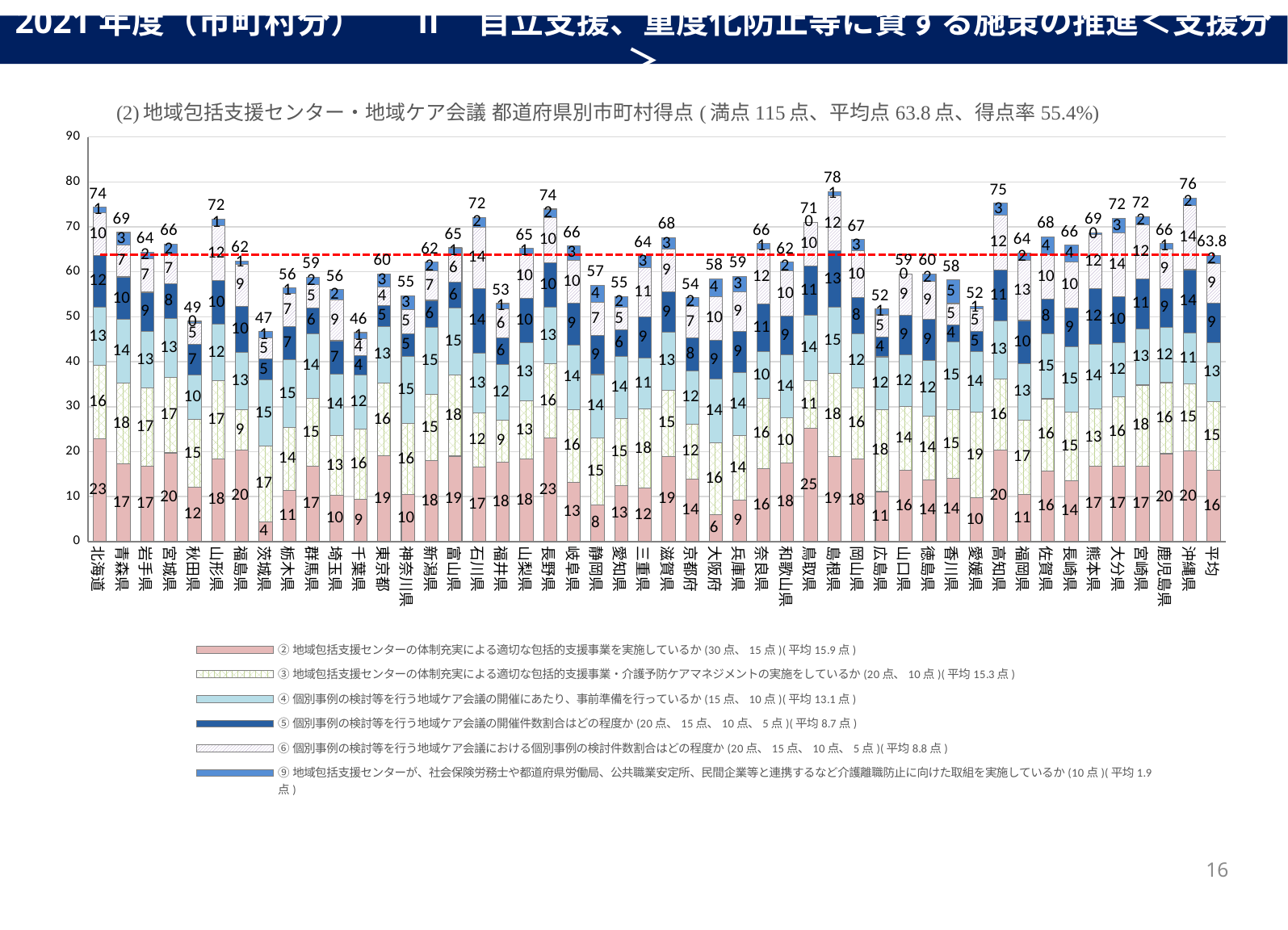
What value does the red dashed horizontal line mark? 63.8 (平均点) Which prefecture has the highest total score? 島根県 What kind of chart is shown on the slide? Stacked bar chart Which prefecture has the lowest total score? 千葉県 What is the total score shown for 沖縄県? 76 Which has a higher total score, 北海道 or 青森県? 北海道 What is the total score shown for 島根県? 78 Is the total score for 秋田県 greater or less than 50? less What is the value of the bottom (pink) segment for 北海道? 23 What is the difference between the total scores of 島根県 and 千葉県? 32 How many series does the legend list? 6 What is the total score shown for 平均 (the average bar)? 63.8